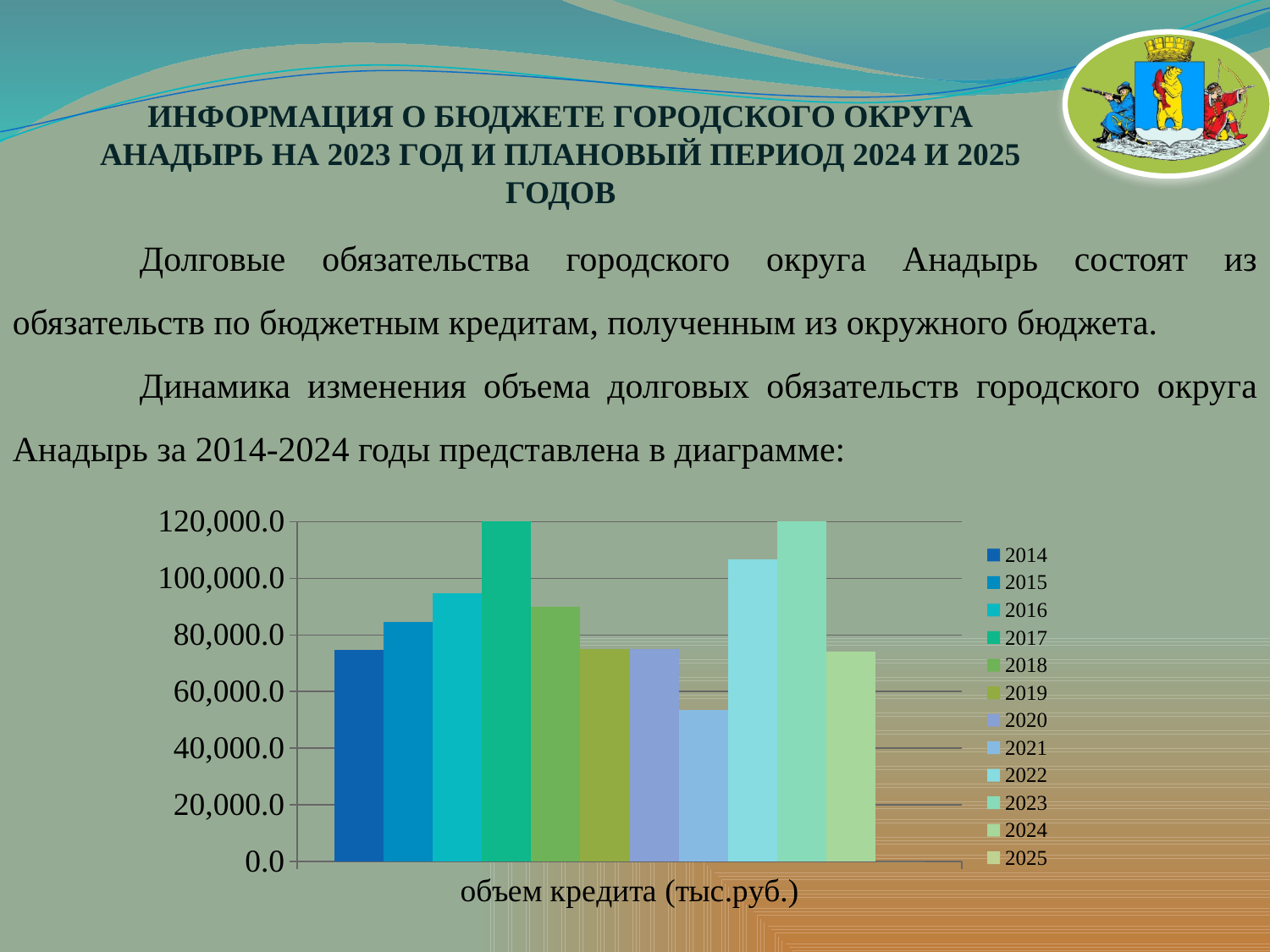
Which is larger, the value for 2022 or the value for 2021? 2022 What is the label shown on the horizontal axis of the chart? объем кредита (тыс.руб.) Is the value for 2022 greater or less than 100,000.0? greater Is the value for 2018 greater or less than 100,000.0? less Is the value for 2016 greater or less than 80,000.0? greater Which is larger, the value for 2016 or the value for 2014? 2016 What is the highest tick value shown on the vertical axis? 120,000.0 How many series does the chart legend list? 12 What kind of chart is shown on the slide? bar chart